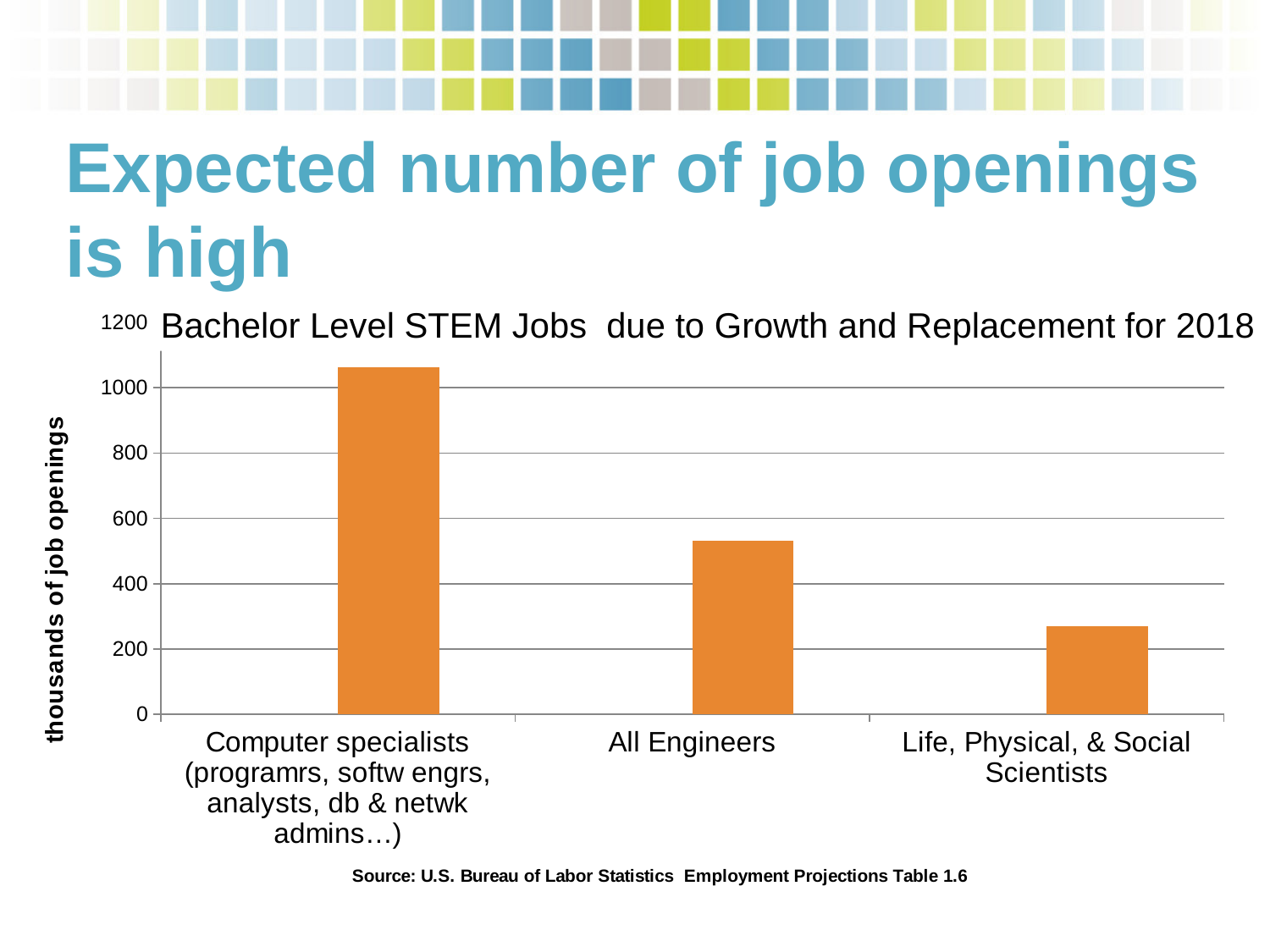
Which category has the lowest number of job openings? Life, Physical, & Social Scientists How many categories are plotted in the chart? 3 Is the value for Life, Physical, & Social Scientists greater or less than 400? less Which category has the highest number of job openings? Computer specialists What is the label on the vertical axis of the chart? thousands of job openings Is the value for All Engineers greater or less than 400? greater What is the title of the chart? Bachelor Level STEM Jobs due to Growth and Replacement for 2018 Is the value for All Engineers greater or less than 600? less Which has more job openings, All Engineers or Life, Physical, & Social Scientists? All Engineers What kind of chart is shown on the slide? bar chart Do the values rise or fall moving from left to right across the categories? fall